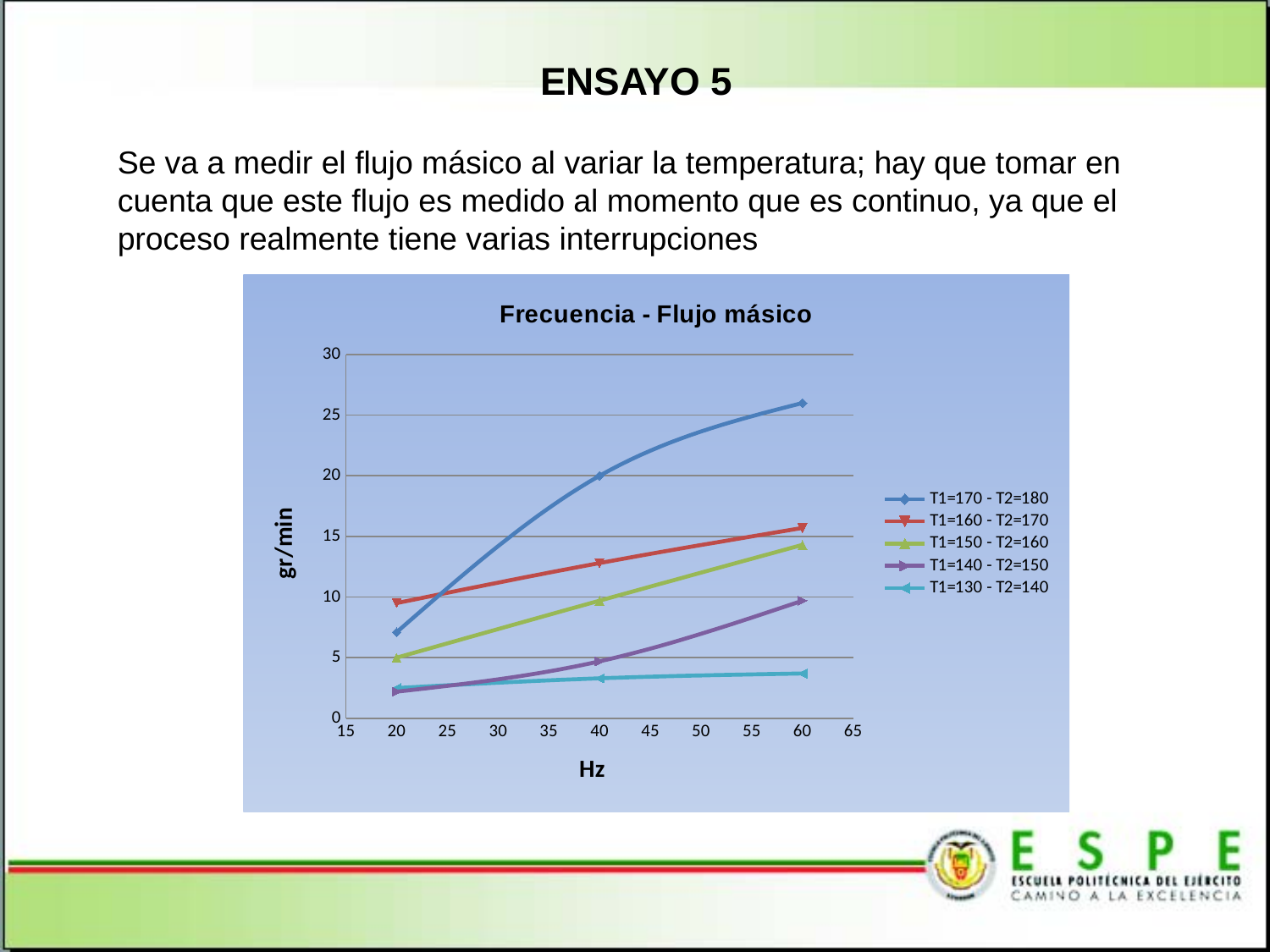
What is the label of the y axis of the chart? gr/min Is the value for T1=160 - T2=170 at 20 Hz greater or less than 5? greater Which series has the highest value at 60 Hz? T1=170 - T2=180 What is the title of the chart? Frecuencia - Flujo másico Which series has the lowest value at 60 Hz? T1=130 - T2=140 At 20 Hz, which is larger: T1=160 - T2=170 or T1=170 - T2=180? T1=160 - T2=170 What kind of chart is shown on the slide? line chart How many series does the legend of the chart list? 5 Does the value for T1=170 - T2=180 rise or fall as Hz increases? rise Is the value for T1=170 - T2=180 at 60 Hz greater or less than 25? greater How many data points are plotted for each series? 3 Is the value for T1=130 - T2=140 at 60 Hz greater or less than 5? less